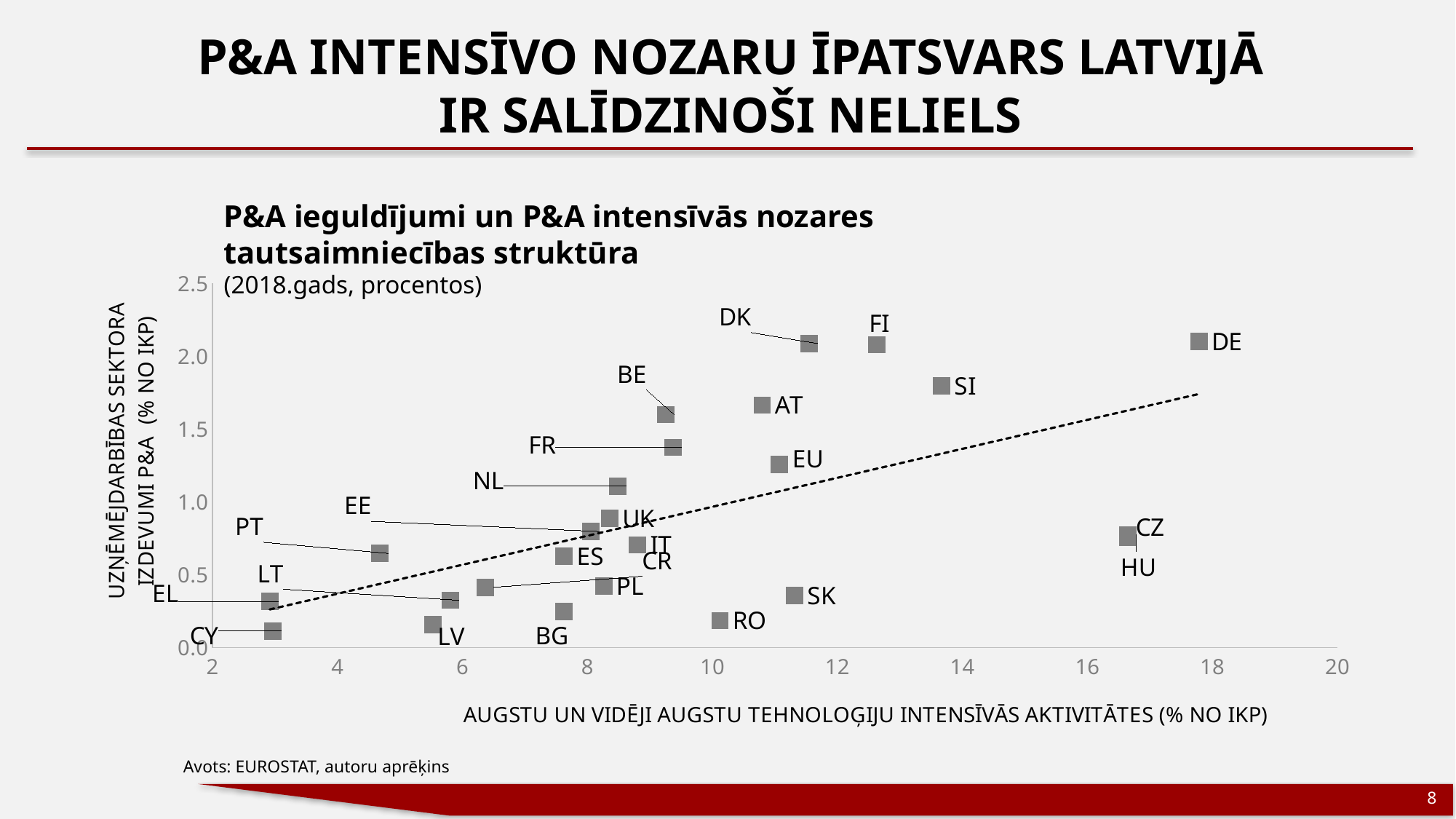
Does the dotted trend line rise or fall as the horizontal-axis value increases? rises Is the horizontal-axis value for DE greater or less than 16? greater Is the vertical-axis value for RO greater or less than 0.5? less Which has the larger horizontal-axis value, CZ or LV? CZ Which country has the highest value on the horizontal axis (high and medium-high technology intensive activities, % of GDP)? DE Which year does the chart's data refer to, according to the chart subtitle? 2018 Which has the larger vertical-axis value, AT or SK? AT Is the vertical-axis value for EU greater or less than 1.0? greater What kind of chart is shown on the slide? scatter chart